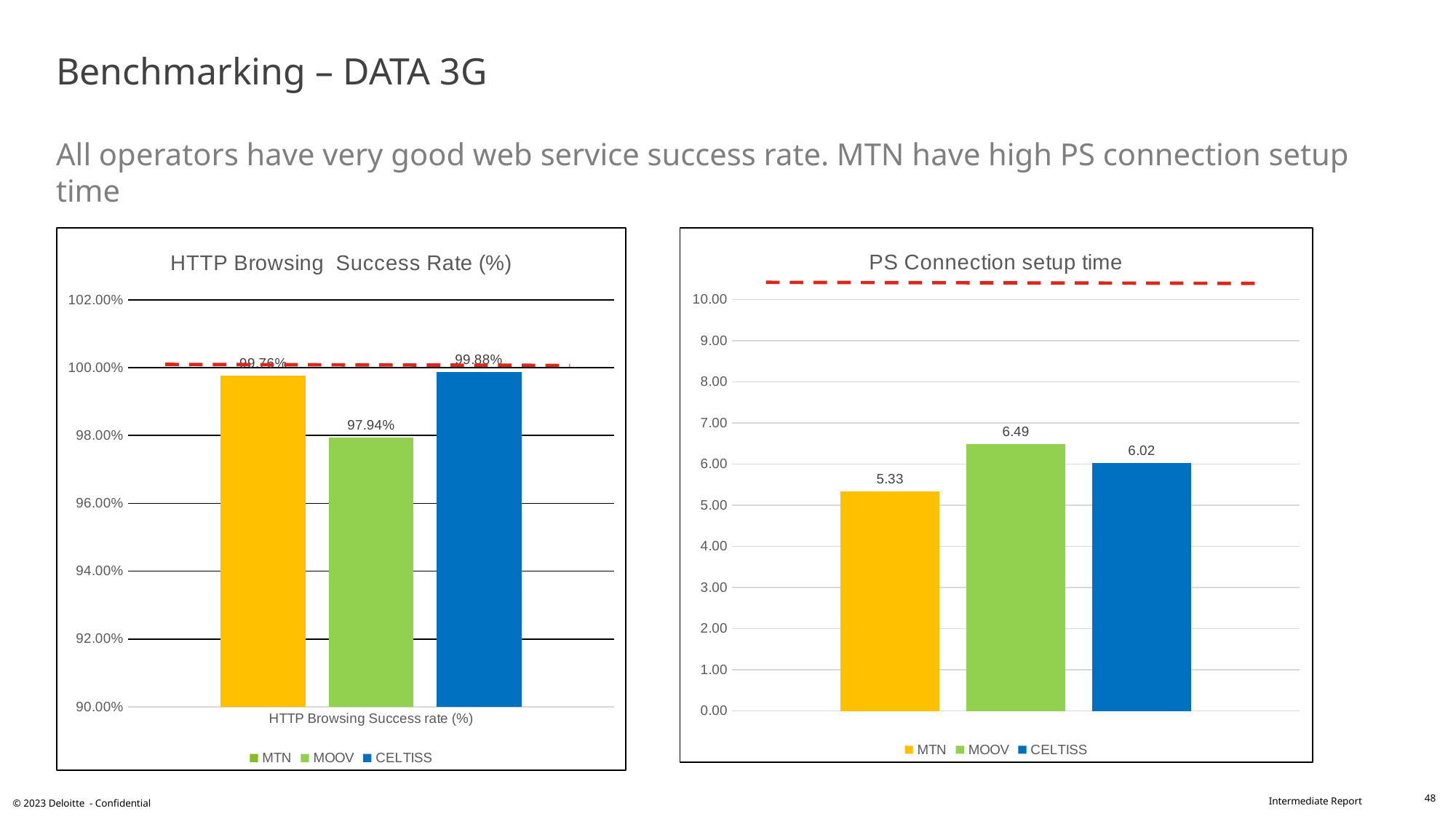
In the PS Connection setup time chart, what is the value for MTN? 5.33 In the PS Connection setup time chart, what is the value for CELTISS? 6.02 In the PS Connection setup time chart, what is the value for MOOV? 6.49 In the PS Connection setup time chart, which operator has the lowest value? MTN In the PS Connection setup time chart, what is the difference between the MOOV and MTN values? 1.16 In the HTTP Browsing Success Rate (%) chart, is the value for MTN greater or less than 98.00%? greater In the PS Connection setup time chart, which operator has the highest value? MOOV In the HTTP Browsing Success Rate (%) chart, which operator has the lowest success rate? MOOV How many series does the legend of the PS Connection setup time chart list? 3 In the HTTP Browsing Success Rate (%) chart, what is the value for MOOV? 97.94% In the HTTP Browsing Success Rate (%) chart, what is the value for CELTISS? 99.88% In the PS Connection setup time chart, which is larger, the value for CELTISS or the value for MOOV? MOOV